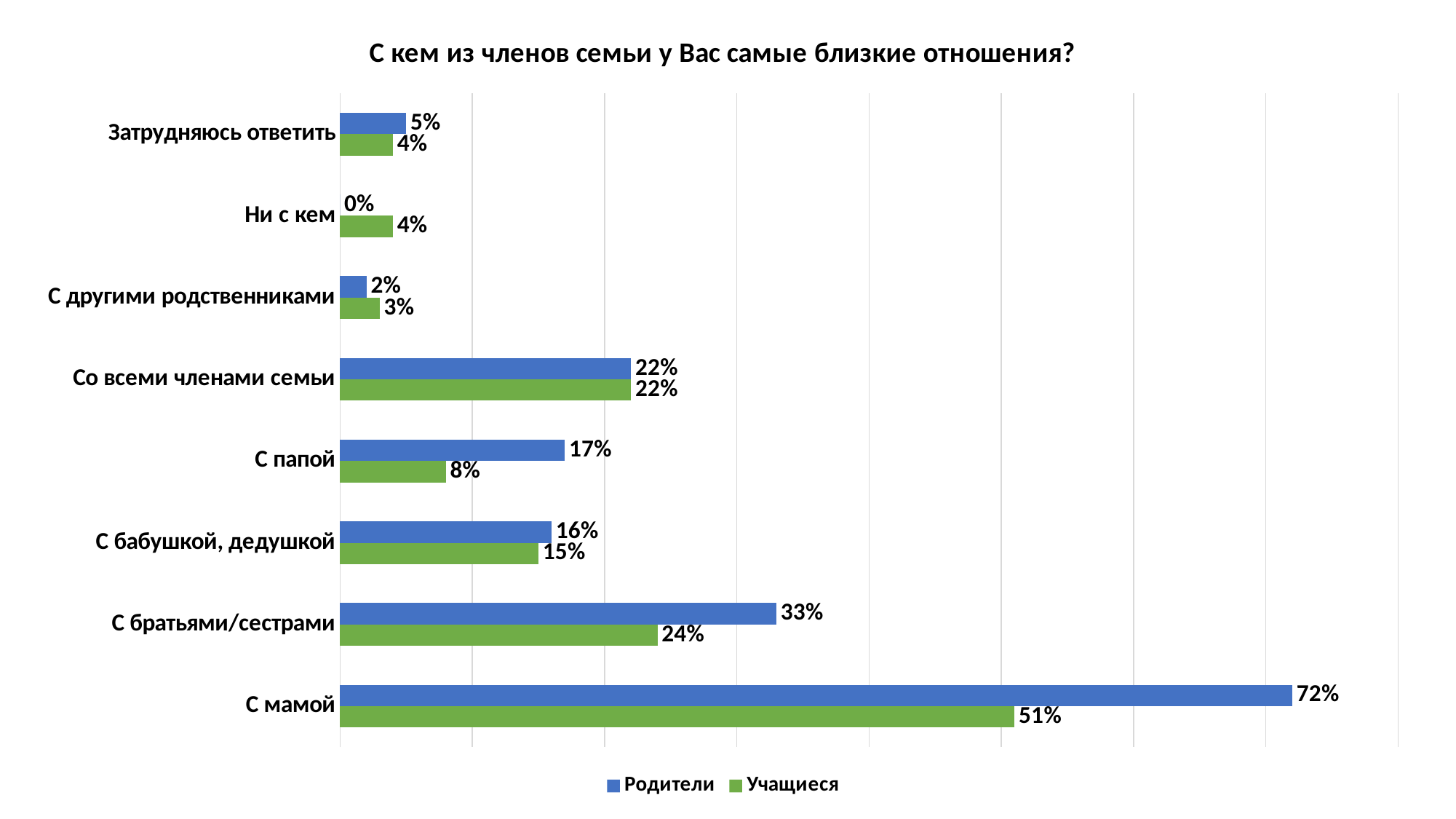
Which series is shown in green? Учащиеся What kind of chart is shown on the slide? Bar chart Which is larger for С папой: the Родители value or the Учащиеся value? Родители How many series does the legend list? 2 Which category has the highest value for Учащиеся? С мамой What is the value for Учащиеся in the category С папой? 8% What is the difference between the Родители and Учащиеся values for С братьями/сестрами? 9% What is the title of the chart? С кем из членов семьи у Вас самые близкие отношения? What is the value for Родители in the category С мамой? 72% Which category has the lowest value for Родители? Ни с кем What is the value for Учащиеся in the category Ни с кем? 4% How many categories are shown on the chart? 8